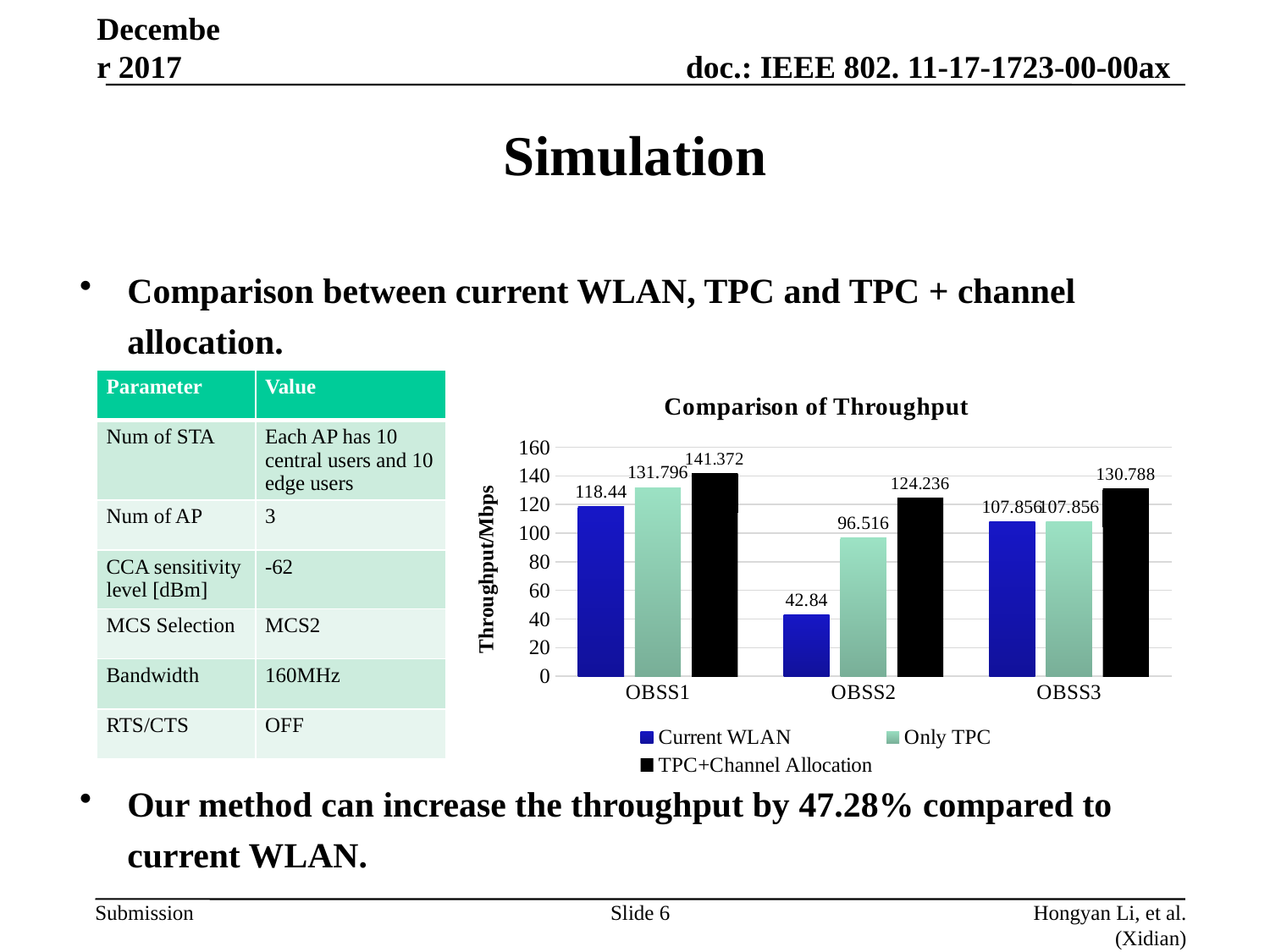
How many categories are shown on the x axis of the chart? 3 Which category has the lowest Current WLAN throughput? OBSS2 Which category has the highest TPC+Channel Allocation throughput? OBSS1 What is the throughput for Current WLAN in OBSS1? 118.44 What is the throughput for Only TPC in OBSS2? 96.516 Is the Current WLAN throughput in OBSS2 greater or less than 60? less What is the title of the chart? Comparison of Throughput Which is larger in OBSS1: the Only TPC throughput or the Current WLAN throughput? Only TPC What type of chart is shown on the slide? bar chart What is the difference between the TPC+Channel Allocation and Current WLAN throughput in OBSS2? 81.396 What is the throughput for TPC+Channel Allocation in OBSS3? 130.788 How many series does the chart legend list? 3